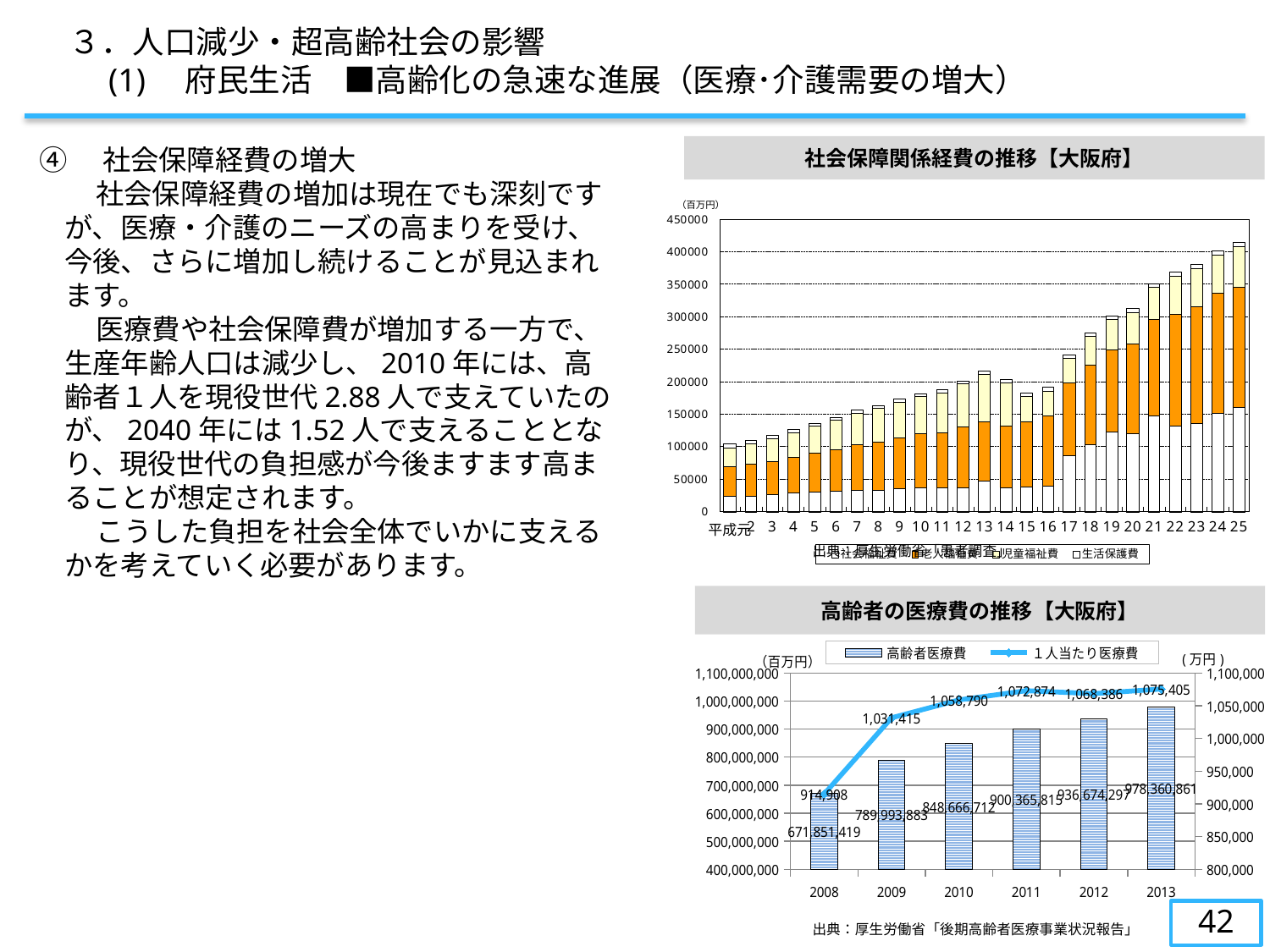
In the chart titled 高齢者の医療費の推移【大阪府】, what is the value of 1人当たり医療費 for 2008? 914,908 In the chart titled 高齢者の医療費の推移【大阪府】, by how much did 1人当たり医療費 increase from 2008 to 2009? 116,507 In the chart titled 高齢者の医療費の推移【大阪府】, which year has the highest 1人当たり医療費? 2013 In the chart titled 社会保障関係経費の推移【大阪府】, what kind of chart is shown? Stacked bar chart In the chart titled 高齢者の医療費の推移【大阪府】, what is the value of 高齢者医療費 for 2010? 848,666,712 In the chart titled 高齢者の医療費の推移【大阪府】, which year has the lowest 高齢者医療費? 2008 In the chart titled 社会保障関係経費の推移【大阪府】, do the totals generally rise or fall from 平成元 to 平成25? rise In the chart titled 高齢者の医療費の推移【大阪府】, how many series does the legend list? 2 In the chart titled 高齢者の医療費の推移【大阪府】, what is the value of 高齢者医療費 for 2013? 978,360,861 In the chart titled 社会保障関係経費の推移【大阪府】, is the total for 平成25 greater or less than 400000? greater In the chart titled 高齢者の医療費の推移【大阪府】, is 1人当たり医療費 higher in 2011 or in 2012? 2011 In the chart titled 高齢者の医療費の推移【大阪府】, what is the difference in 高齢者医療費 between 2013 and 2008? 306,509,442